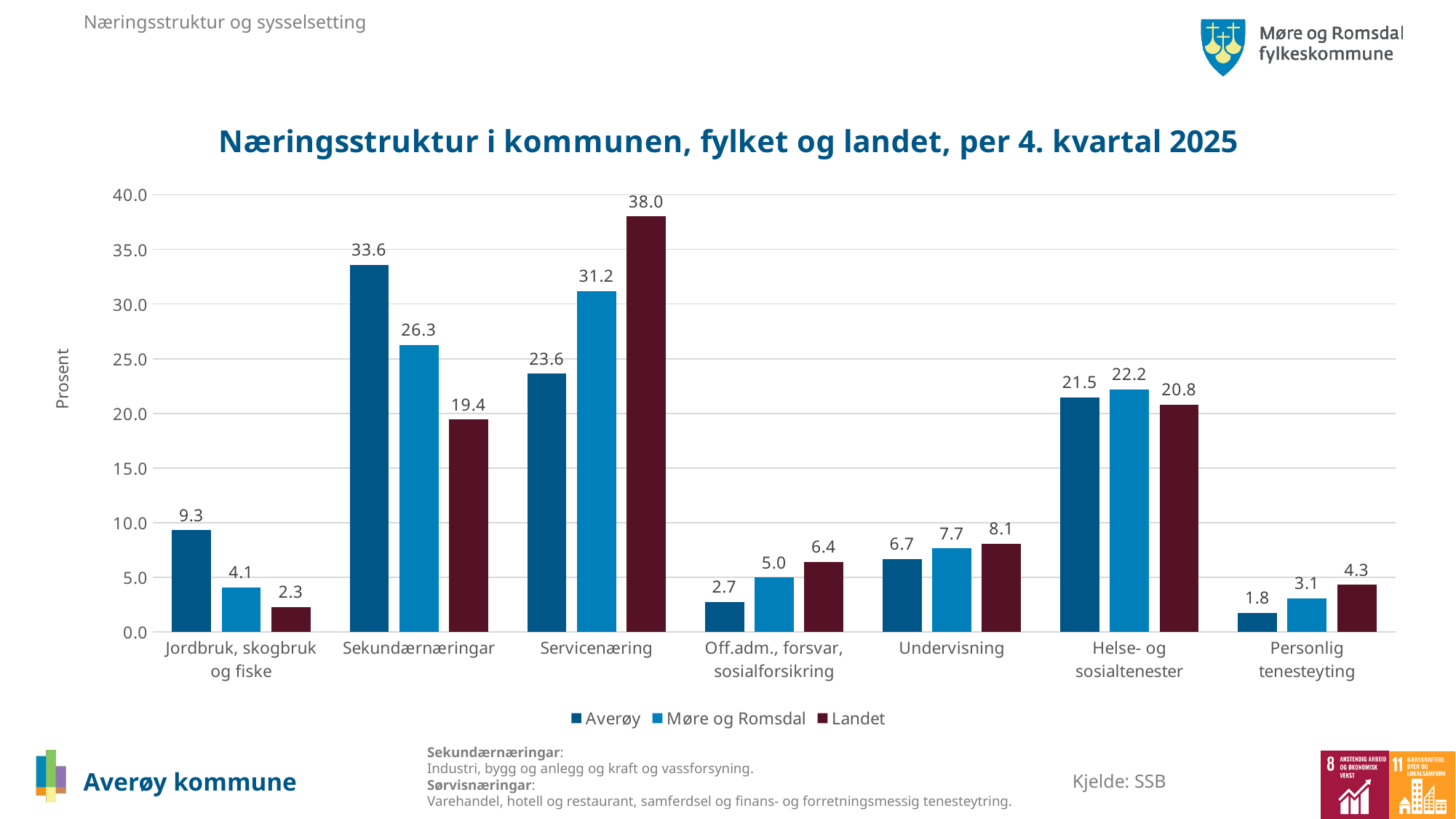
What kind of chart is shown on the slide? Bar chart What is the value for Averøy in the Sekundærnæringar category? 33.6 Which category has the highest value for Averøy? Sekundærnæringar What is the title of the chart? Næringsstruktur i kommunen, fylket og landet, per 4. kvartal 2025 What is the value for Møre og Romsdal in the Helse- og sosialtenester category? 22.2 Is the value for Møre og Romsdal in the Servicenæring category greater or less than 30.0? greater Which is larger in the Undervisning category: the value for Averøy or the value for Landet? Landet How many series does the legend list? 3 How many categories are shown on the x axis? 7 What is the difference between the Averøy and Landet values in the Jordbruk, skogbruk og fiske category? 7.0 Which category has the lowest value for Landet? Jordbruk, skogbruk og fiske What is the value for Landet in the Servicenæring category? 38.0